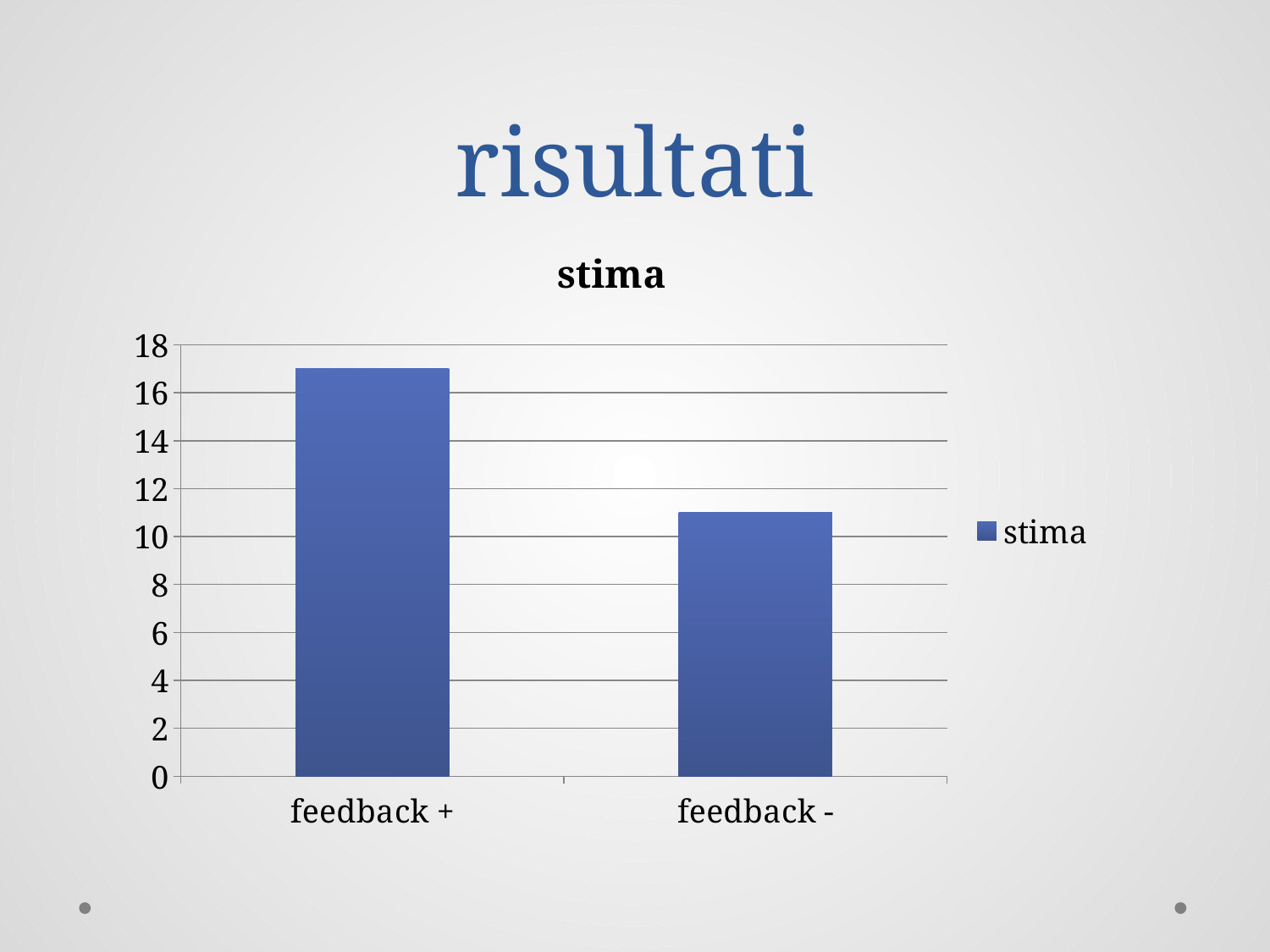
What is the title of the chart? stima How many categories are shown on the x axis of the chart? 2 Is the value for feedback - greater or less than 10? greater Which category has the lowest value? feedback - Which is larger, the value for feedback + or the value for feedback -? feedback + Is the value for feedback - greater or less than 12? less What kind of chart is shown on the slide? bar chart Is the value for feedback + greater or less than 16? greater How many series does the legend list? 1 What is the name of the series shown in the legend? stima Which category has the highest value? feedback + Do the values rise or fall from feedback + to feedback -? fall